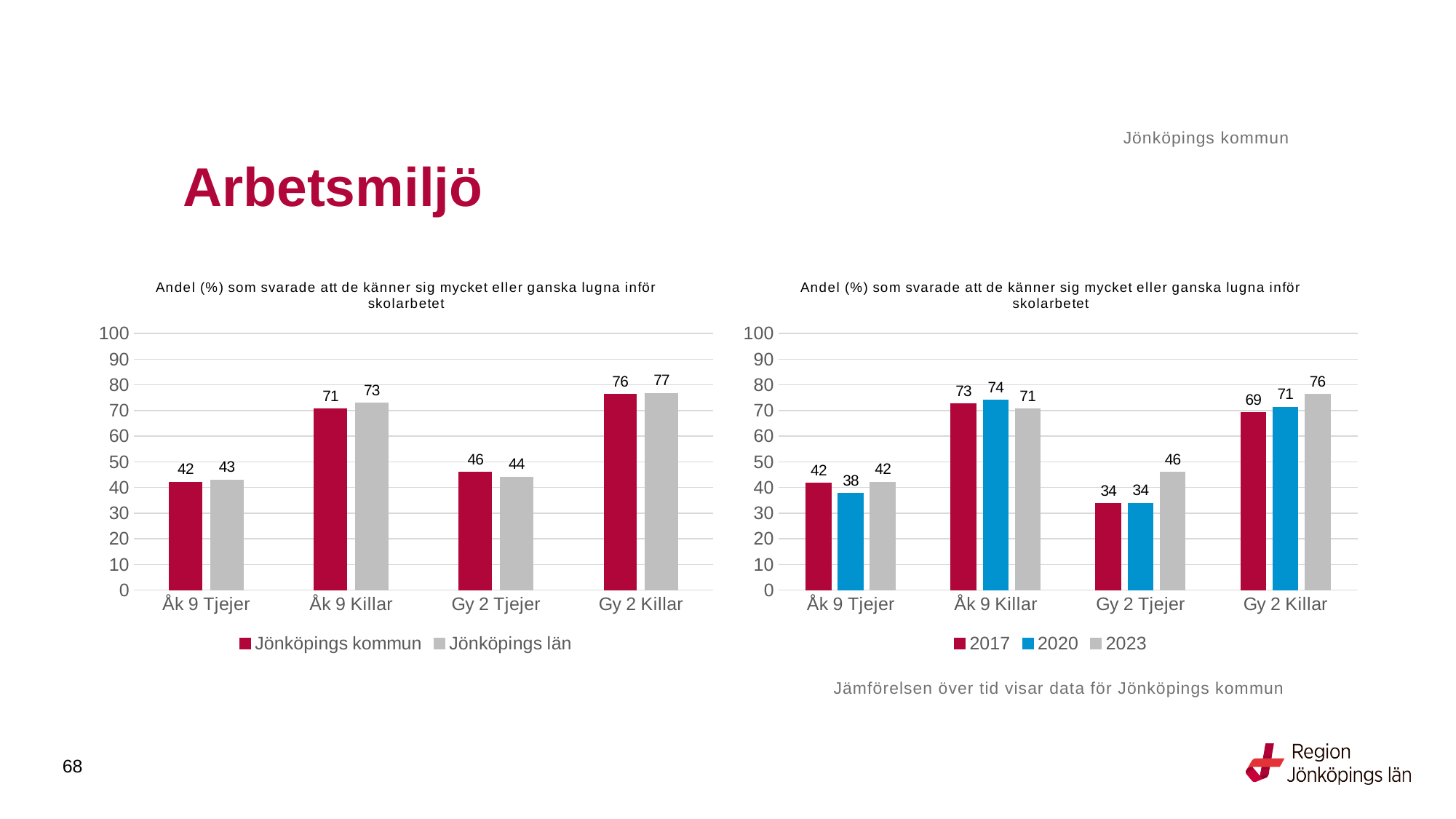
In the left chart, what is the value for Jönköpings kommun for Åk 9 Killar? 71 In the left chart, what is the difference between Jönköpings län and Jönköpings kommun for Gy 2 Killar? 1 In the right chart, what is the value for 2020 for Åk 9 Tjejer? 38 In the right chart, what is the difference between the 2023 and 2017 values for Gy 2 Tjejer? 12 In the right chart, which category has the lowest value for 2017? Gy 2 Tjejer In the right chart, what is the value for 2023 for Gy 2 Tjejer? 46 In the right chart, how many categories are shown on the x axis? 4 In the left chart, what is the value for Jönköpings län for Gy 2 Tjejer? 44 In the left chart, which category has the highest value for Jönköpings kommun? Gy 2 Killar In the left chart, how many series does the legend list? 2 In the right chart, which is larger for Åk 9 Killar: the 2020 value or the 2023 value? 2020 What kind of chart is the right chart? Bar chart